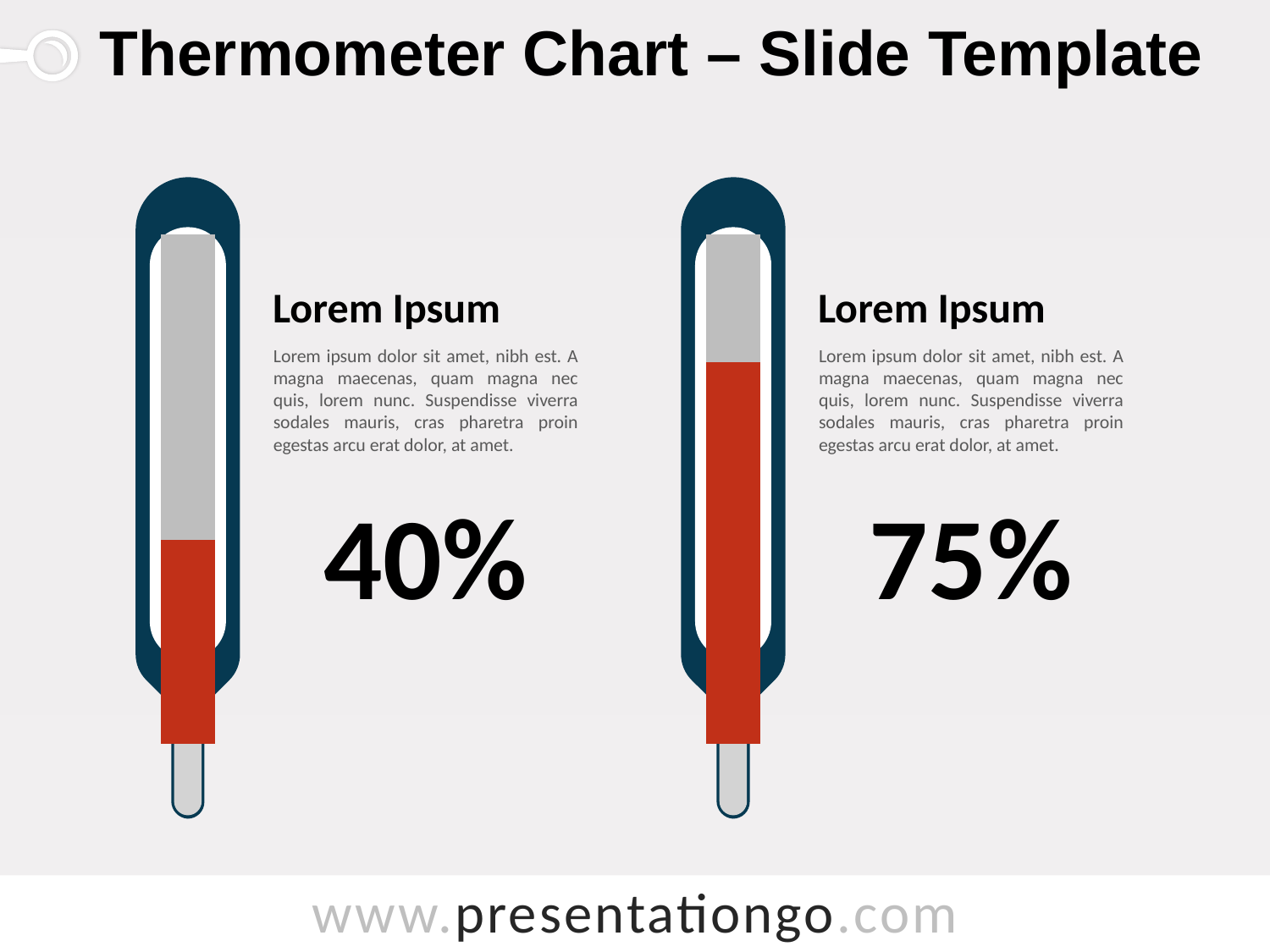
Which thermometer chart shows the higher value, the left or the right? right Is the value shown on the left thermometer chart greater or less than 50%? less How many thermometer charts are shown on the slide? 2 Which thermometer chart shows the lower value, the left or the right? left Is the value of the left thermometer larger or smaller than the value of the right thermometer? smaller What is the difference between the right thermometer's value and the left thermometer's value? 35% What is the title of the slide? Thermometer Chart – Slide Template What value is shown for the left thermometer chart? 40% Is the value shown on the right thermometer chart greater or less than 50%? greater What colour is the filled portion of the thermometers? red What kind of chart is used on this slide to display the percentages? thermometer chart What value is shown for the right thermometer chart? 75%